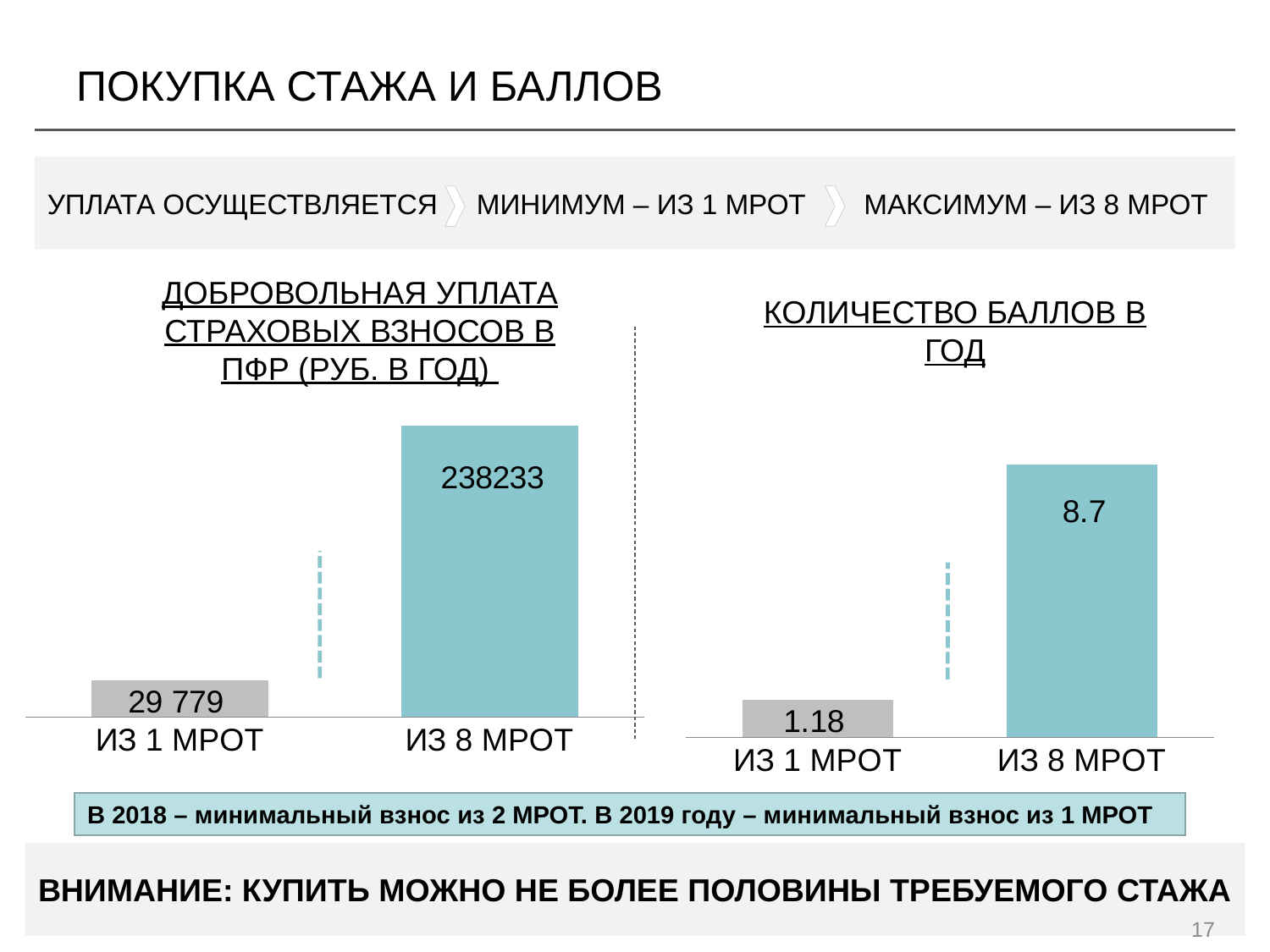
What type of chart is the right chart (КОЛИЧЕСТВО БАЛЛОВ В ГОД)? Bar chart In the right chart (КОЛИЧЕСТВО БАЛЛОВ В ГОД), what is the value for ИЗ 8 МРОТ? 8.7 In the left chart (ДОБРОВОЛЬНАЯ УПЛАТА СТРАХОВЫХ ВЗНОСОВ В ПФР), what is the value for ИЗ 1 МРОТ? 29 779 In the right chart (КОЛИЧЕСТВО БАЛЛОВ В ГОД), which is larger: the value for ИЗ 1 МРОТ or ИЗ 8 МРОТ? ИЗ 8 МРОТ In the left chart (ДОБРОВОЛЬНАЯ УПЛАТА СТРАХОВЫХ ВЗНОСОВ В ПФР), which category has the highest value? ИЗ 8 МРОТ In the left chart (ДОБРОВОЛЬНАЯ УПЛАТА СТРАХОВЫХ ВЗНОСОВ В ПФР), what is the value for ИЗ 8 МРОТ? 238233 In the right chart (КОЛИЧЕСТВО БАЛЛОВ В ГОД), which category has the lowest value? ИЗ 1 МРОТ In the right chart (КОЛИЧЕСТВО БАЛЛОВ В ГОД), what is the value for ИЗ 1 МРОТ? 1.18 What is the title of the right chart on the slide? КОЛИЧЕСТВО БАЛЛОВ В ГОД In the right chart (КОЛИЧЕСТВО БАЛЛОВ В ГОД), what is the difference between the values for ИЗ 8 МРОТ and ИЗ 1 МРОТ? 7.52 In the left chart (ДОБРОВОЛЬНАЯ УПЛАТА СТРАХОВЫХ ВЗНОСОВ В ПФР), what is the difference between the values for ИЗ 8 МРОТ and ИЗ 1 МРОТ? 208454 How many categories are shown in the left chart (ДОБРОВОЛЬНАЯ УПЛАТА СТРАХОВЫХ ВЗНОСОВ В ПФР)? 2